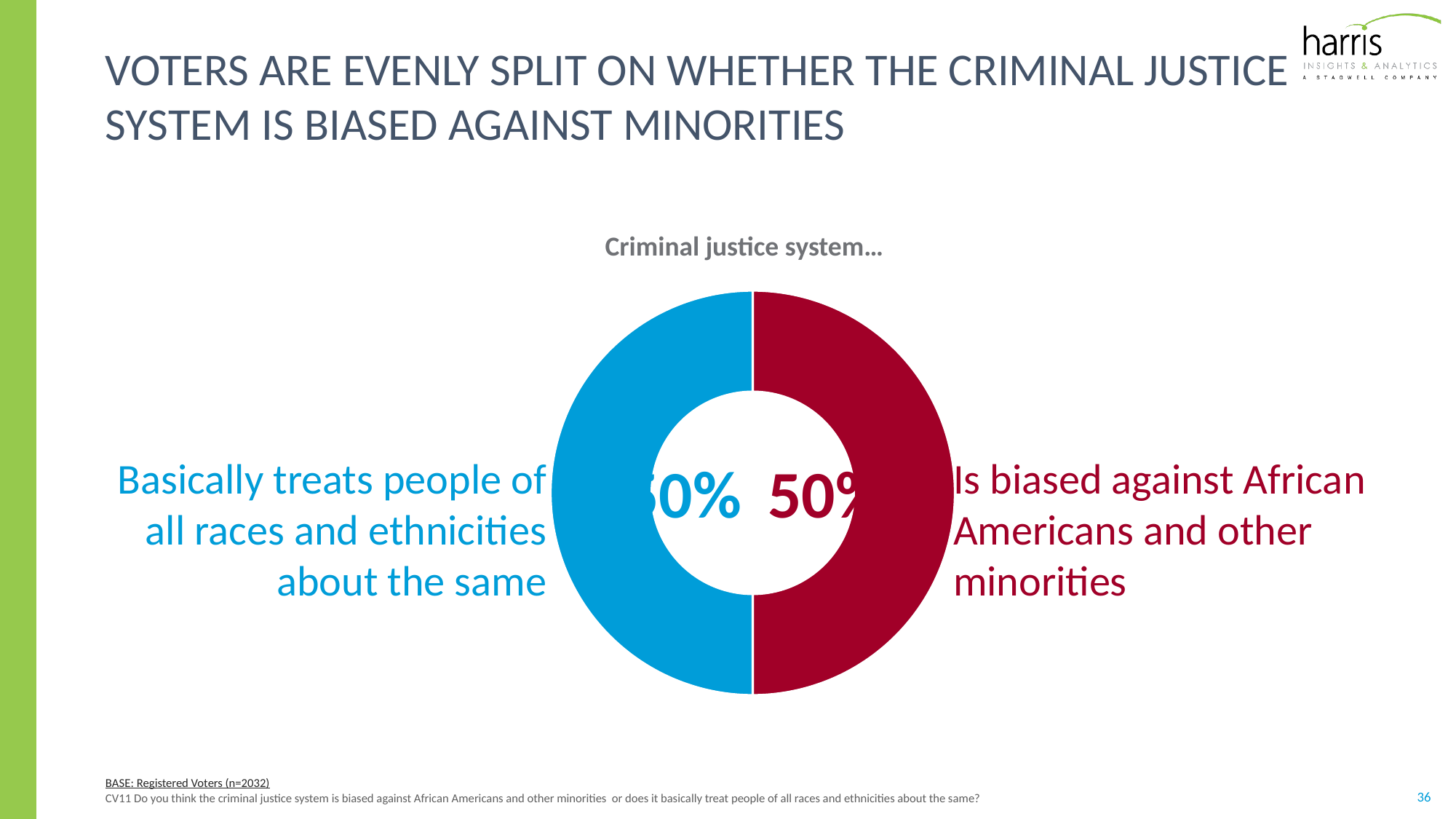
What kind of chart is shown on the slide? Donut (pie) chart What share of voters say the criminal justice system is biased against African Americans and other minorities? 50% Is the share for 'Basically treats people of all races and ethnicities about the same' greater or less than 60%? less Which colour represents the slice 'Is biased against African Americans and other minorities'? Red Is the share for 'Is biased against African Americans and other minorities' greater or less than 40%? greater How many slices does the chart have? 2 What is the total of the two slices shown in the chart? 100% What share of voters say the criminal justice system basically treats people of all races and ethnicities about the same? 50% What is the title of the chart? Criminal justice system… What is the difference between the share saying the system is biased and the share saying it treats people about the same? 0%